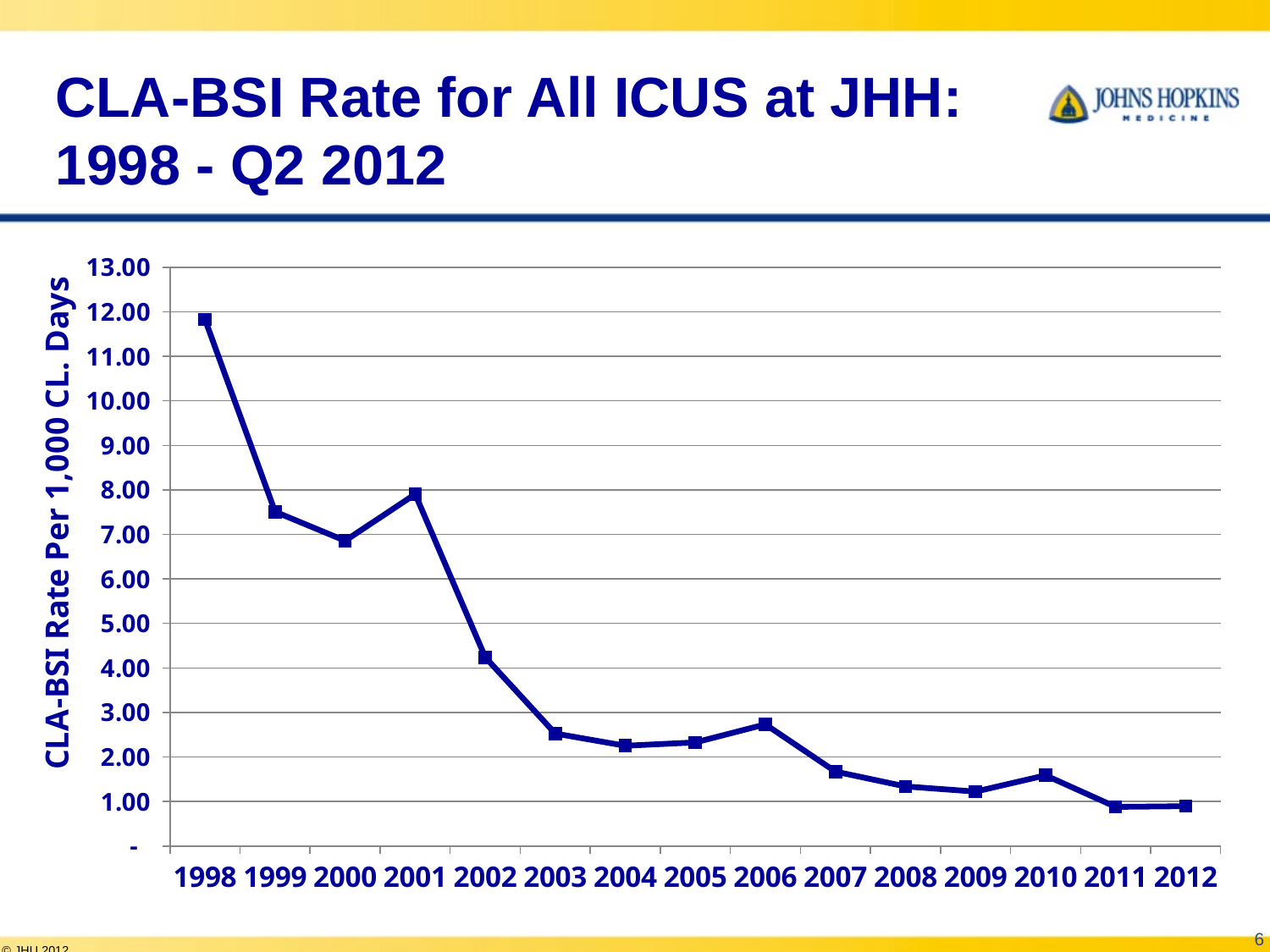
How many years are plotted on the x axis? 15 Is the value for 2003 greater or less than 3.00? less Is the value for 2007 greater or less than 2.00? less Is the value for 2002 greater or less than 4.00? greater Overall, does the CLA-BSI rate rise or fall from 1998 to 2012? fall What kind of chart is shown on the slide? line chart What is the label on the y axis of the chart? CLA-BSI Rate Per 1,000 CL. Days Which year has the highest CLA-BSI rate? 1998 Which year has the larger CLA-BSI rate, 1999 or 2001? 2001 Which year has the larger CLA-BSI rate, 2006 or 2007? 2006